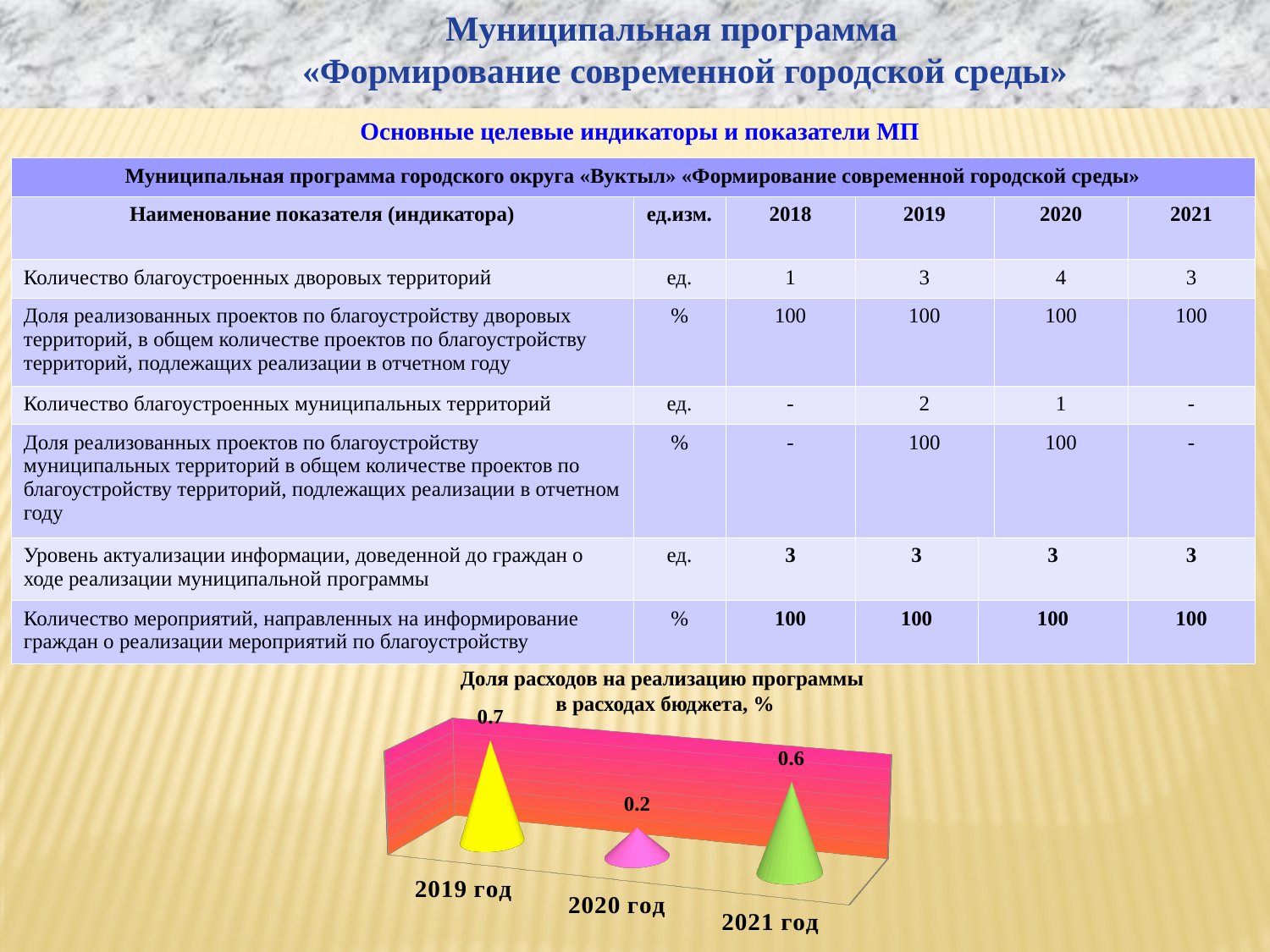
Which year has the lowest value in the chart? 2020 год Does the value fall or rise from 2019 год to 2020 год? fall What colour is the cone for 2019 год? yellow What is the difference between the values for 2021 год and 2020 год? 0.4 Which year has the highest value in the chart? 2019 год Which is larger, the value for 2021 год or the value for 2020 год? 2021 год What is the difference between the values for 2019 год and 2020 год? 0.5 What is the value for 2021 год in the chart? 0.6 What is the value for 2019 год in the chart "Доля расходов на реализацию программы в расходах бюджета, %"? 0.7 How many years are shown in the chart? 3 What is the title of the chart? Доля расходов на реализацию программы в расходах бюджета, % What is the value for 2020 год in the chart? 0.2